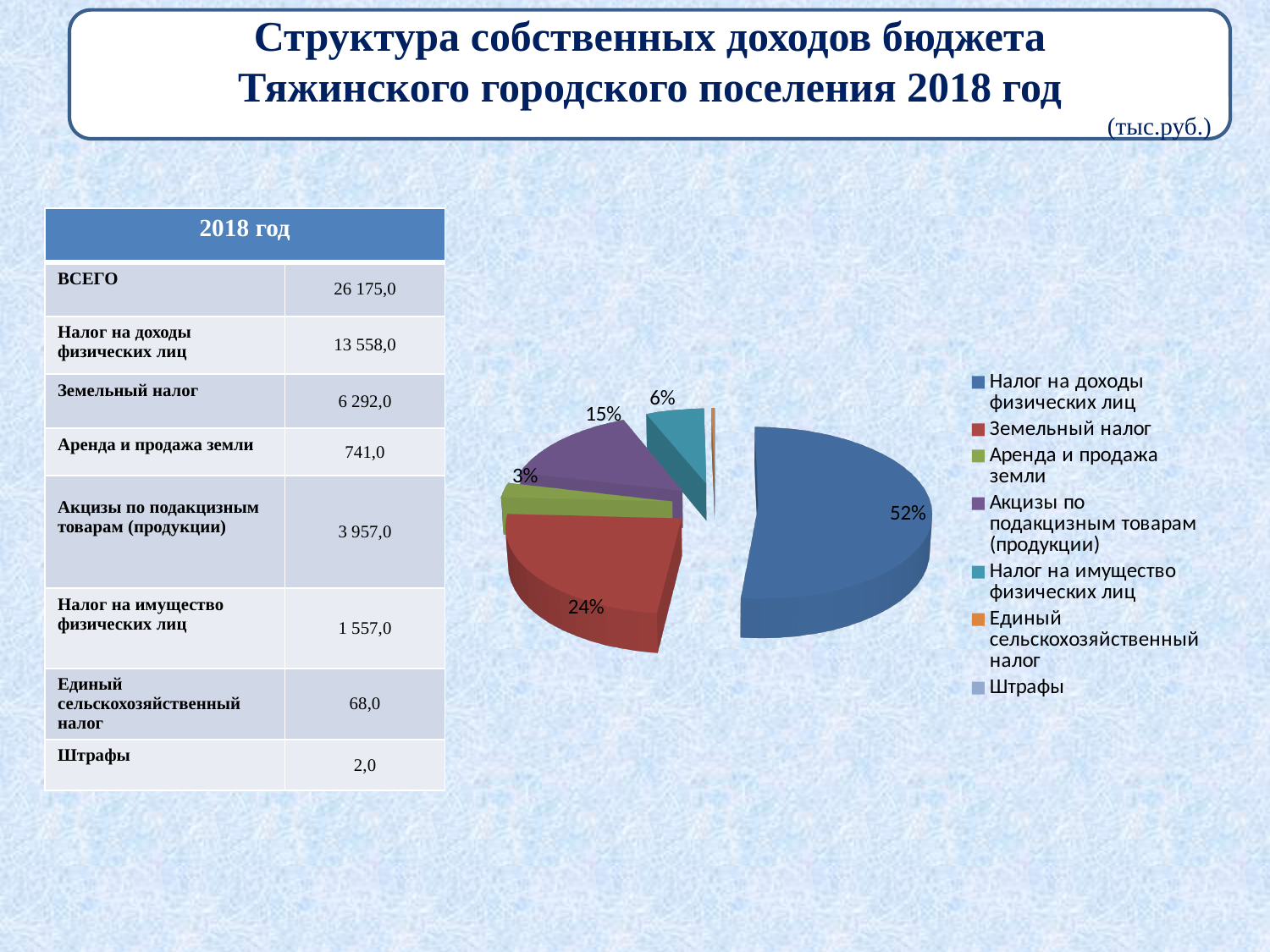
Which is larger in the pie chart: Земельный налог or Акцизы по подакцизным товарам (продукции)? Земельный налог What colour is the Земельный налог slice in the pie chart? red What share of the pie does Акцизы по подакцизным товарам (продукции) have? 15% What share of the pie does Аренда и продажа земли have? 3% What share of the pie does Налог на имущество физических лиц have? 6% How many entries does the pie chart's legend list? 7 What is the difference in percentage points between the Налог на доходы физических лиц slice and the Земельный налог slice? 28% Which category has the largest slice of the pie chart? Налог на доходы физических лиц What is the difference in percentage points between the Акцизы по подакцизным товарам (продукции) slice and the Налог на имущество физических лиц slice? 9% What kind of chart is shown on the slide? pie chart